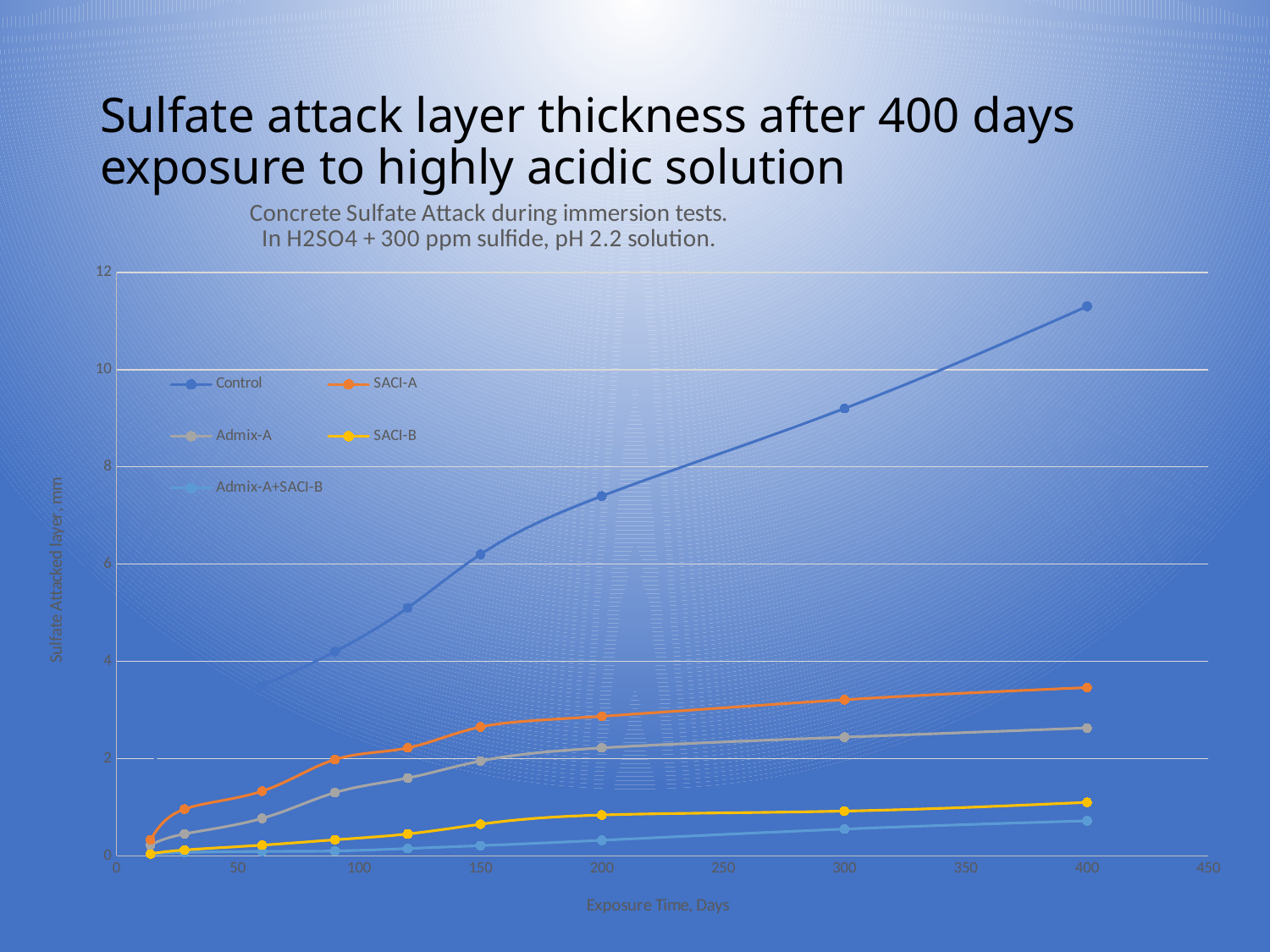
Does the Control series rise or fall as exposure time increases? rise Is the value for SACI-A at 400 days greater or less than 4? less Is the value for Control at 300 days greater or less than 8? greater What kind of chart is shown on the slide? line chart Is the value for Control at 400 days greater or less than 10? greater What is the label of the y axis? Sulfate Attacked layer, mm How many series does the legend list? 5 At 400 days, which is larger: SACI-A or Admix-A? SACI-A Which series has the lowest sulfate attacked layer thickness at 400 days? Admix-A+SACI-B What is the label of the x axis? Exposure Time, Days Which series has the highest sulfate attacked layer thickness at 400 days? Control